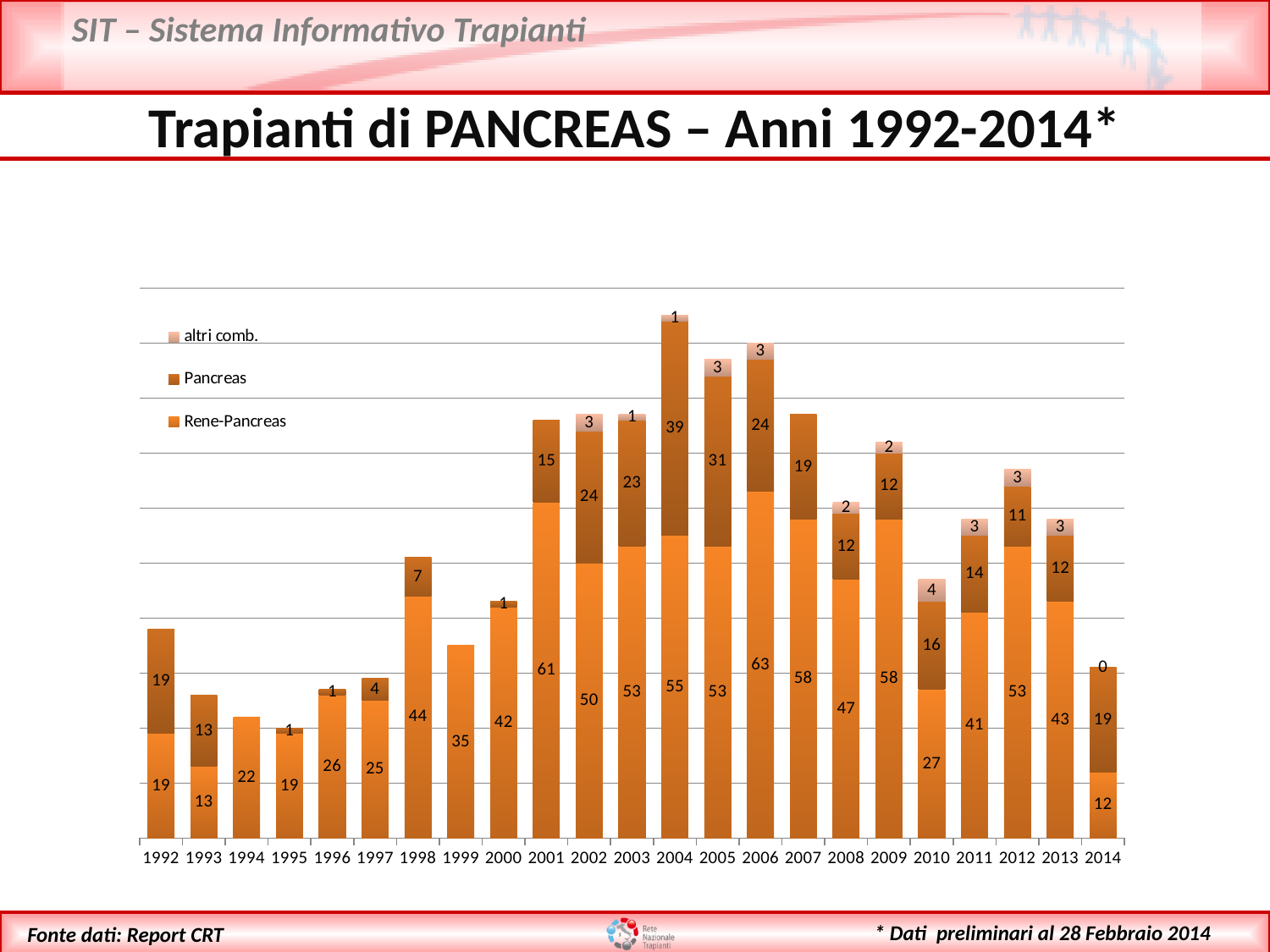
What is the Rene-Pancreas value for 2006? 63 Which year has the highest Rene-Pancreas value? 2006 Which is larger, the Pancreas value for 2005 or the Pancreas value for 2007? 2005 How many years are shown on the x axis? 23 What is the altri comb. value for 2010? 4 What is the total of the stacked bar for 2004? 95 What is the difference between the Rene-Pancreas values for 2001 and 2010? 34 What is the title of the chart? Trapianti di PANCREAS – Anni 1992-2014* What kind of chart is shown on the slide? stacked bar chart Which year has the lowest Rene-Pancreas value? 2014 How many series does the legend list? 3 What is the Pancreas value for 2004? 39